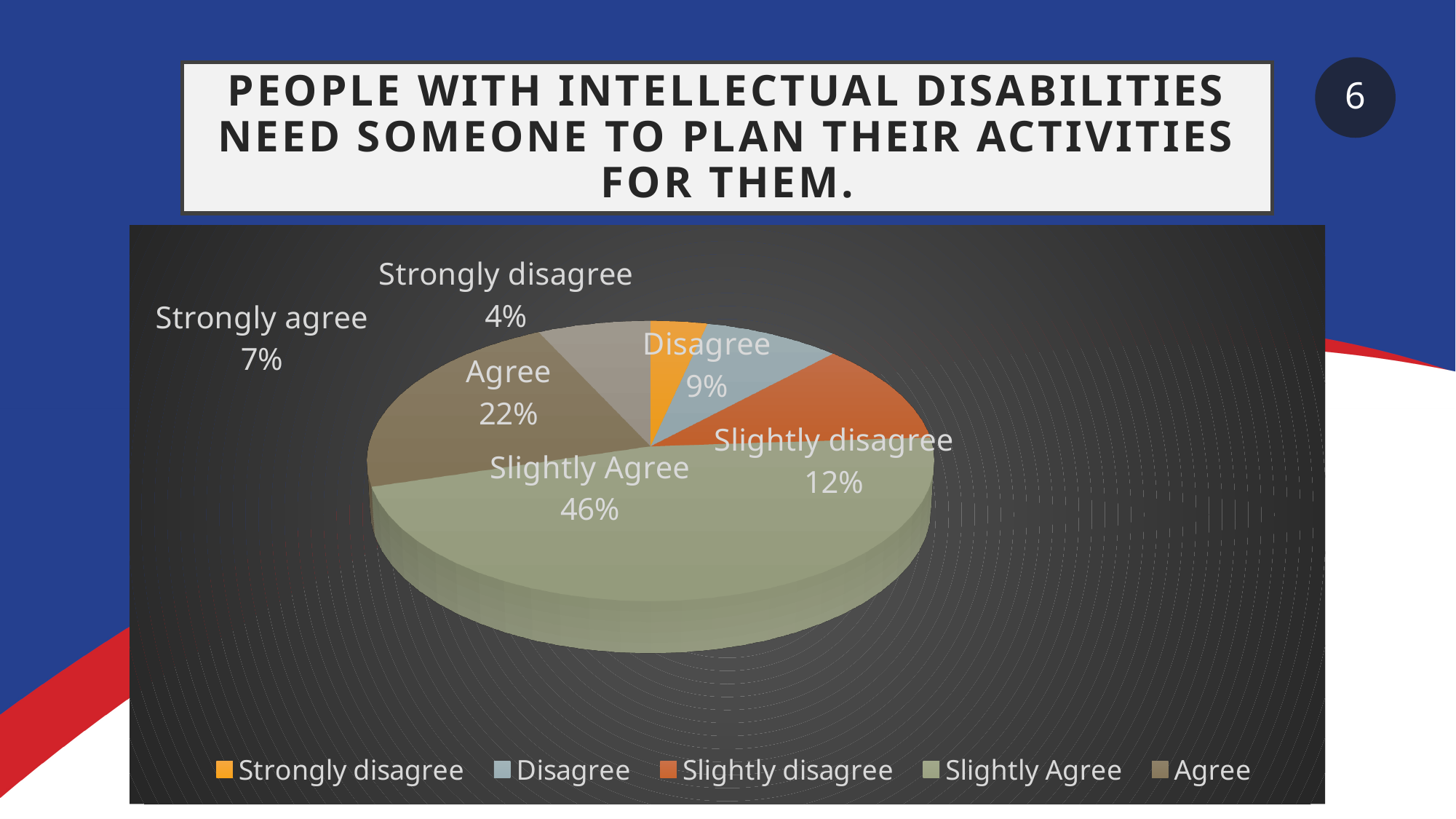
What is the difference in percentage points between Slightly Agree and Agree? 24 What percentage of respondents chose Strongly disagree? 4% How many response categories are shown in the pie chart? 6 What colour is the Slightly disagree slice? Orange-red What percentage of respondents chose Agree? 22% What percentage of respondents chose Slightly Agree? 46% What kind of chart is shown on the slide? Pie chart Which response category has the largest share of the pie? Slightly Agree Which response category has the smallest share of the pie? Strongly disagree Which is larger, the share for Slightly disagree or the share for Strongly agree? Slightly disagree How many entries does the legend at the bottom of the chart list? 5 What percentage of respondents chose Disagree? 9%